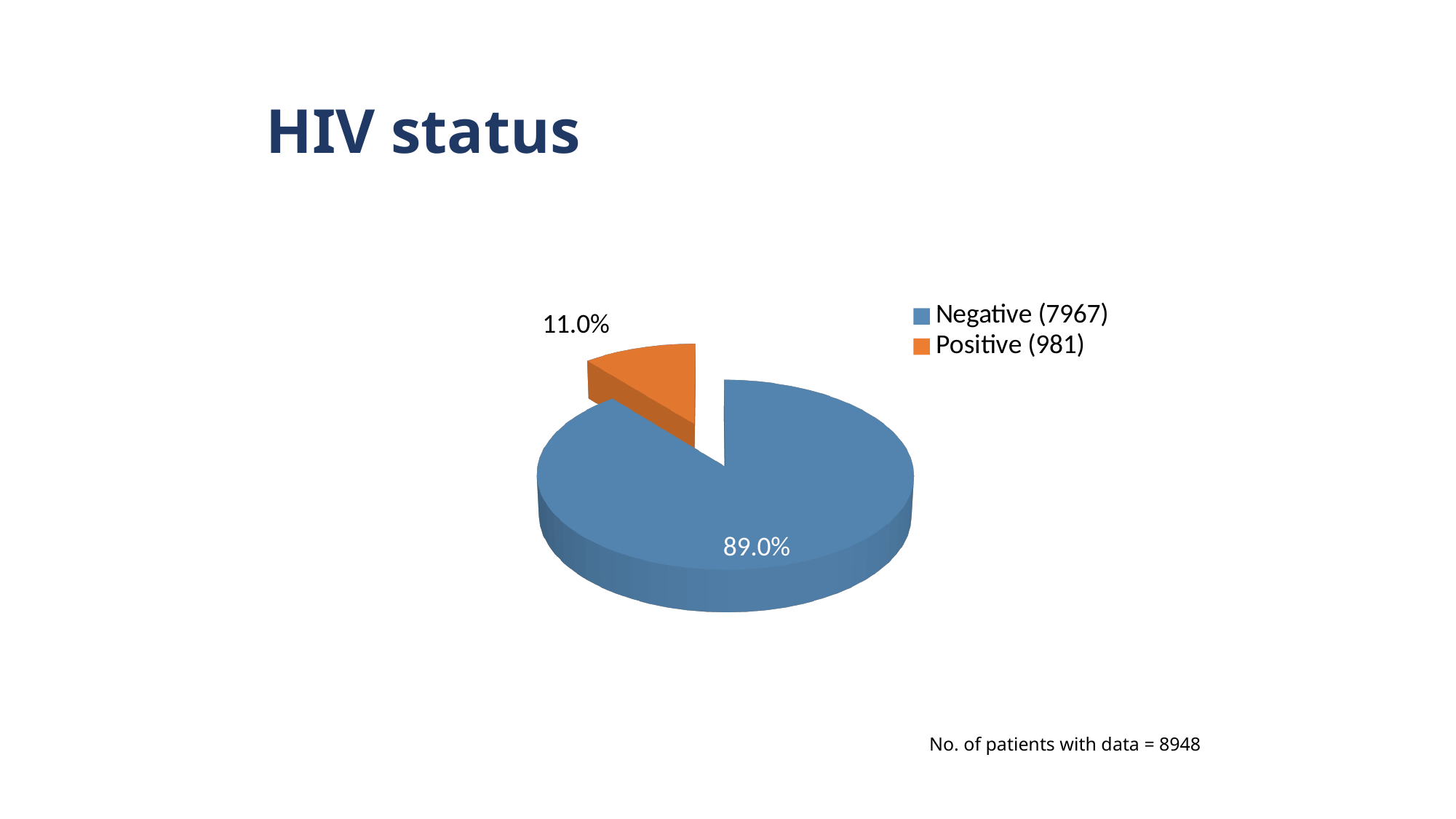
What is the total number of patients with data shown on the slide? 8948 Which HIV status category has the largest share of the pie? Negative What percentage of patients are HIV Negative? 89.0% What colour is the Positive slice of the pie chart? Orange What is the difference in percentage points between the Negative and Positive slices? 78.0% How many patients are HIV Negative according to the legend? 7967 Which is larger, the Negative slice or the Positive slice? Negative Which HIV status category has the smallest share of the pie? Positive What type of chart is shown on the slide? Pie chart What percentage of patients are HIV Positive? 11.0% How many categories does the pie chart show? 2 How many patients are HIV Positive according to the legend? 981